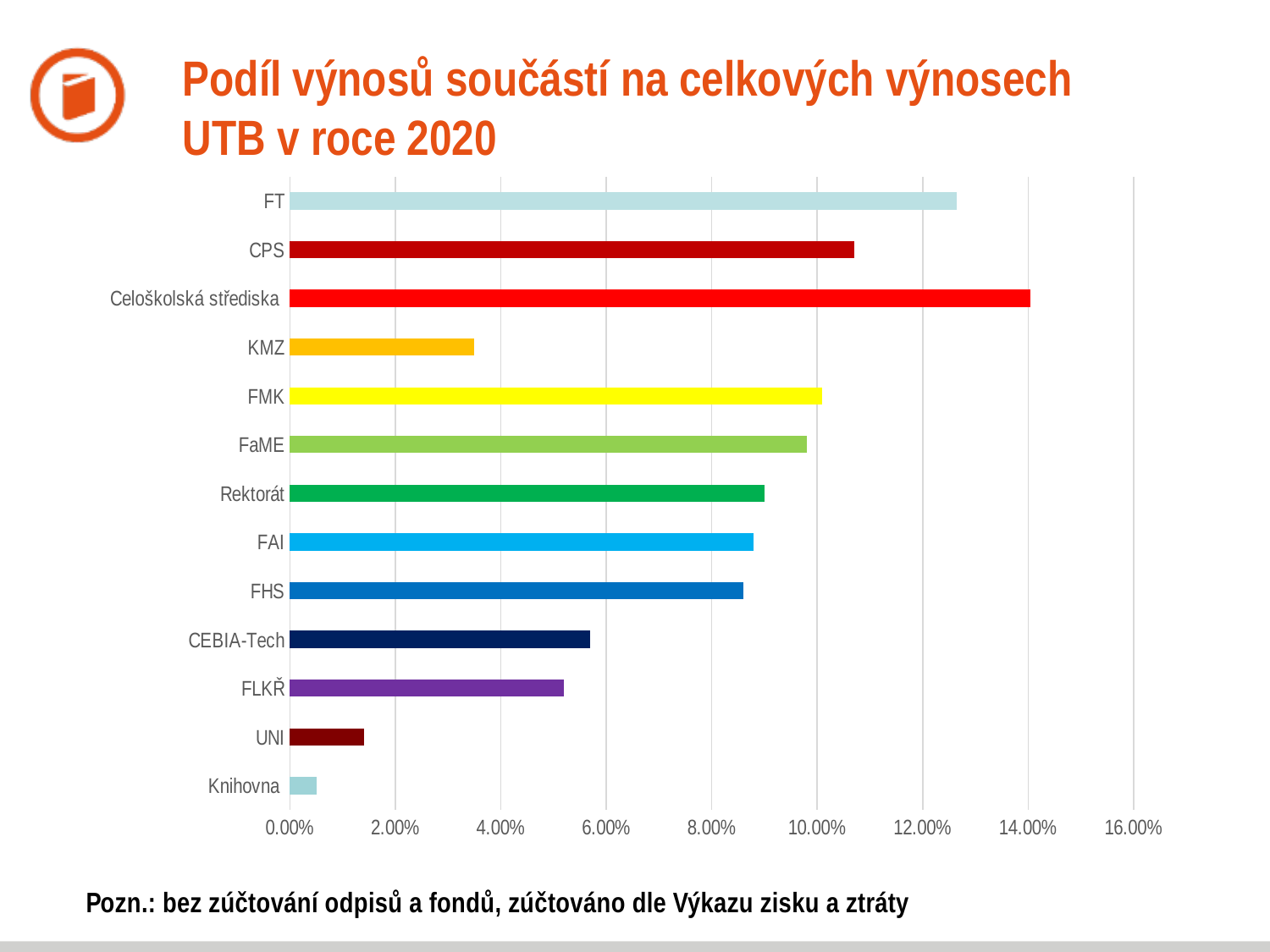
Which has a larger share, KMZ or CEBIA-Tech? CEBIA-Tech What kind of chart is shown on the slide? bar chart Is the value for Rektorát greater or less than 8.00%? greater Which component has the lowest share of total revenues in the chart? Knihovna Is the value for FT greater or less than 12.00%? greater What is the title of the chart on the slide? Podíl výnosů součástí na celkových výnosech UTB v roce 2020 How many categories (components) are plotted in the chart? 13 Is the value for UNI greater or less than 2.00%? less Which has a larger share, FHS or FLKŘ? FHS Which component has the highest share of total revenues in the chart? Celoškolská střediska Which has a larger share, FT or CPS? FT